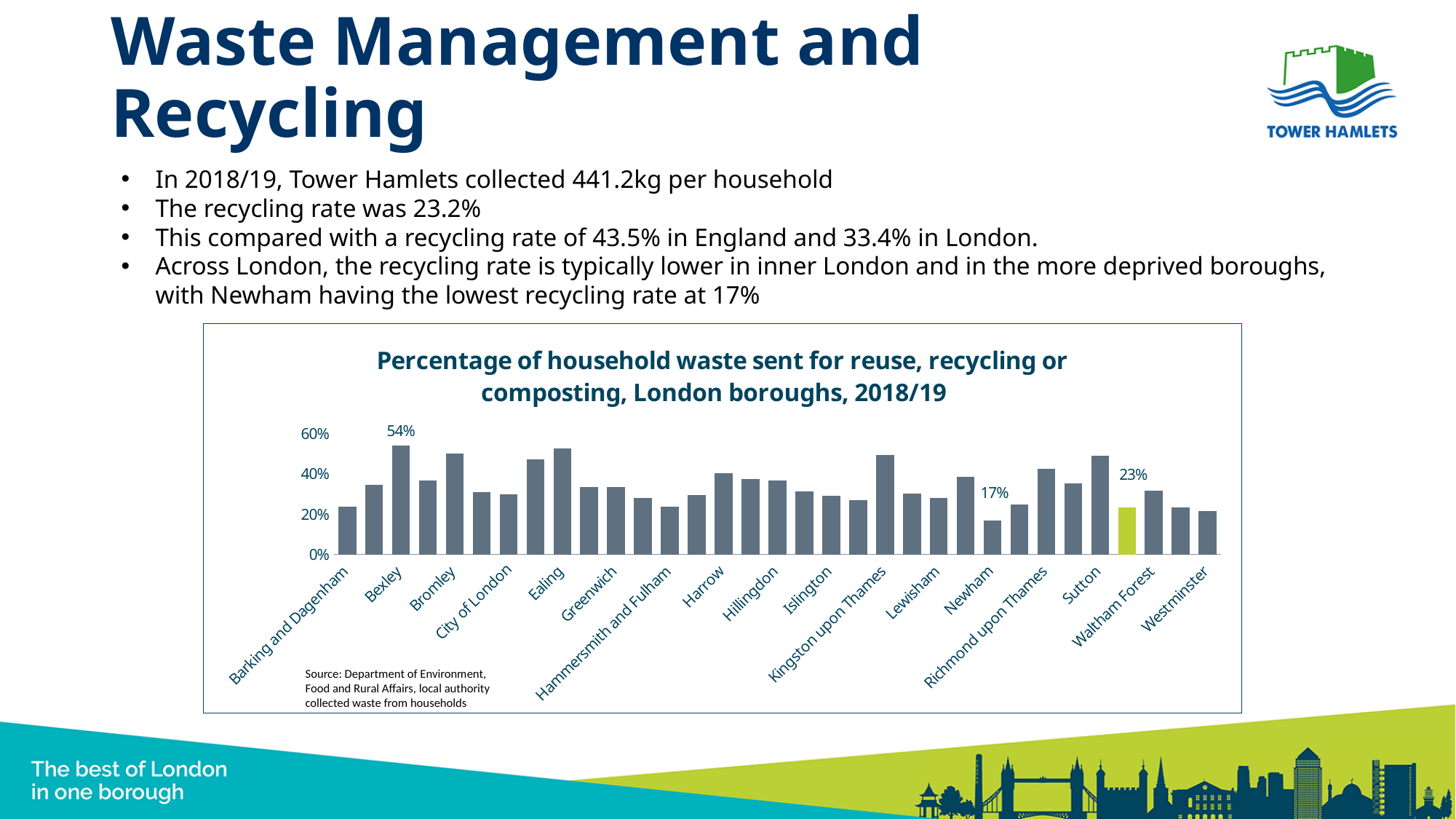
What is the title of the chart? Percentage of household waste sent for reuse, recycling or composting, London boroughs, 2018/19 Which borough has the lowest value in the chart? Newham Which is larger, the value for Ealing or the value for Barking and Dagenham? Ealing What type of chart is shown on the slide? Bar chart What value is labelled on the green highlighted bar? 23% How many bars are plotted in the chart? 33 Is the value for Islington greater or less than 40%? less Is the value for Kingston upon Thames greater or less than 40%? greater What is the difference between the values for Bexley and Newham? 37 percentage points What is the value shown for Newham? 17% Which borough has the highest percentage of household waste sent for reuse, recycling or composting? Bexley What is the value shown for Bexley? 54%